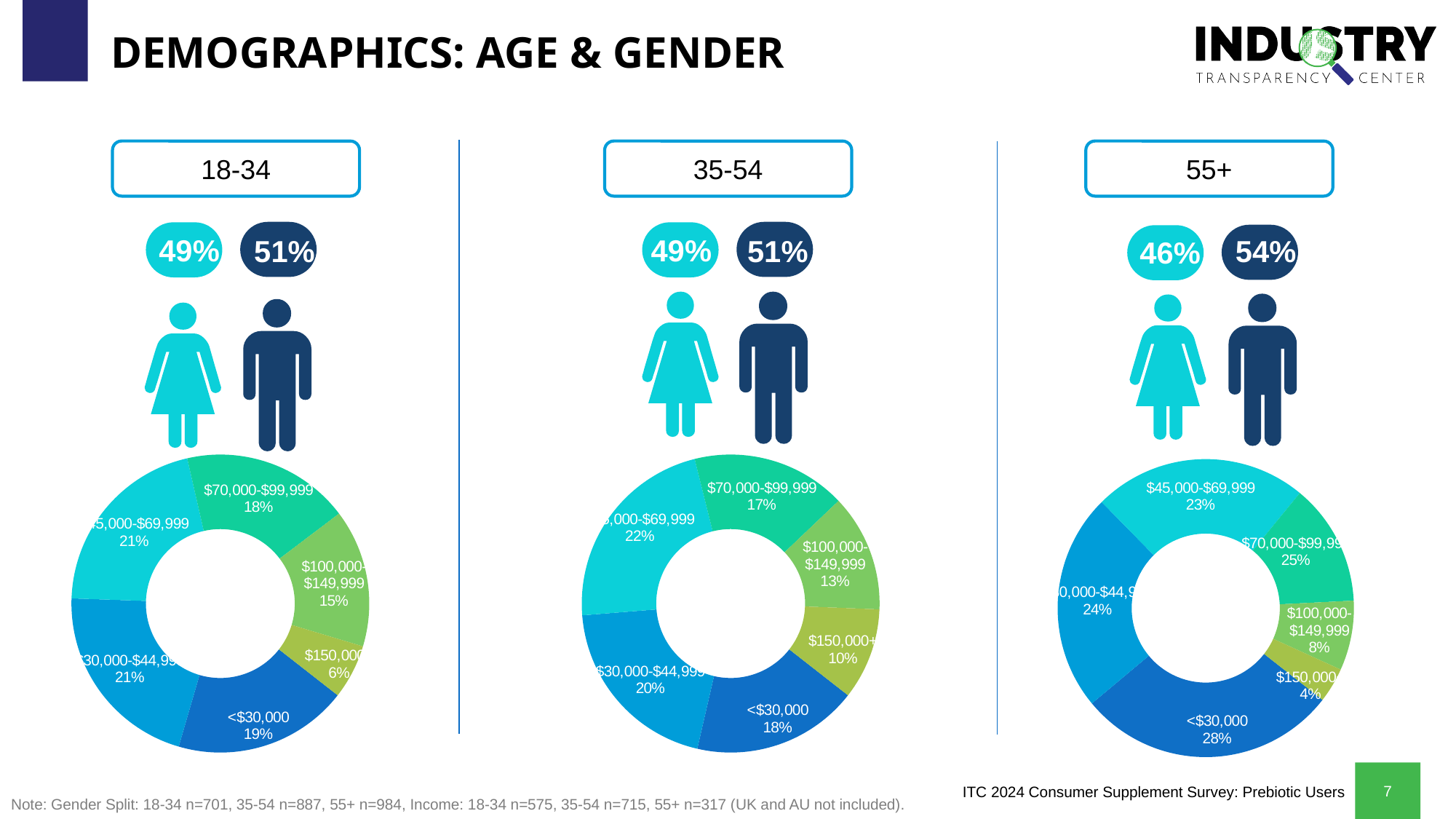
How many income brackets are shown in each donut chart? 6 How many donut charts are shown on the slide? 3 In the 55+ chart, what is the difference between the <$30,000 share and the $150,000+ share? 24 percentage points In the 18-34 chart, what is the difference between the $70,000-$99,999 share and the $150,000+ share? 12 percentage points What kind of chart is used to show the income distribution for each age group? Donut (pie) chart In the 55+ chart, what share of respondents earn less than $30,000? 28% In the 55+ chart, which income bracket has the largest share? <$30,000 In the 35-54 chart, which is larger: the $45,000-$69,999 share or the $70,000-$99,999 share? $45,000-$69,999 In the 35-54 chart, what share of respondents earn $150,000+? 10% In the 18-34 chart, what share of respondents earn $100,000-$149,999? 15% In the 18-34 chart, which income bracket has the smallest share? $150,000+ In the 35-54 chart, which income bracket has the smallest share? $150,000+